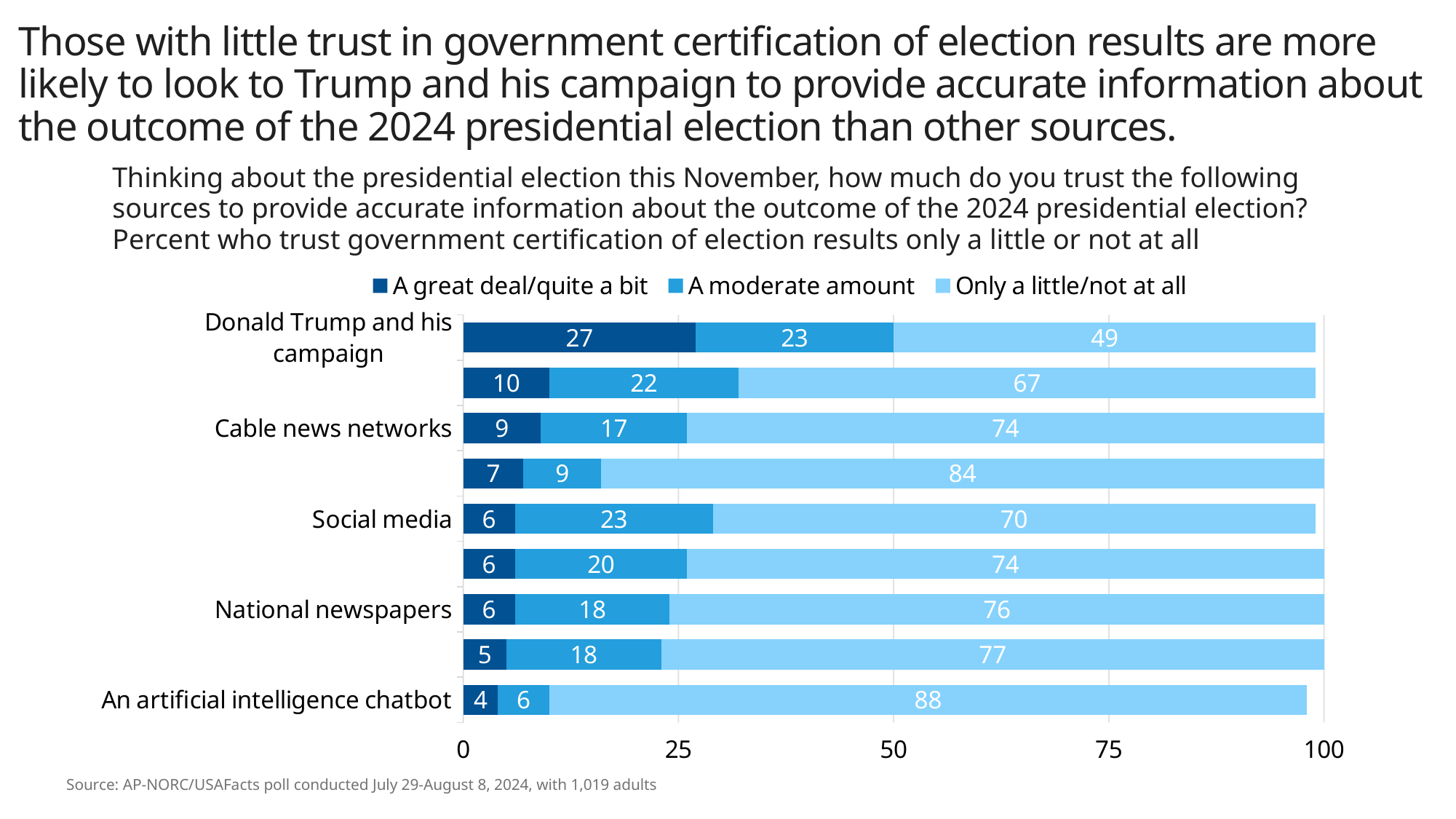
What kind of chart is shown on the slide? Stacked bar chart Among the labeled sources, which has the highest 'A great deal/quite a bit' value? Donald Trump and his campaign What percentage of those with little trust in government certification trust Donald Trump and his campaign a great deal/quite a bit? 27 Among the labeled sources, which has the lowest 'A moderate amount' value? An artificial intelligence chatbot Which is larger: the 'A moderate amount' value for National newspapers or for Cable news networks? National newspapers Which legend entry is shown in the darkest blue? A great deal/quite a bit What is the total of the three segments in the Donald Trump and his campaign bar? 99 What is the 'Only a little/not at all' value for An artificial intelligence chatbot? 88 What is the 'Only a little/not at all' value for Cable news networks? 74 What is the difference between the 'Only a little/not at all' values for An artificial intelligence chatbot and Donald Trump and his campaign? 39 How many series does the legend list? 3 What is the 'A moderate amount' value for Social media? 23